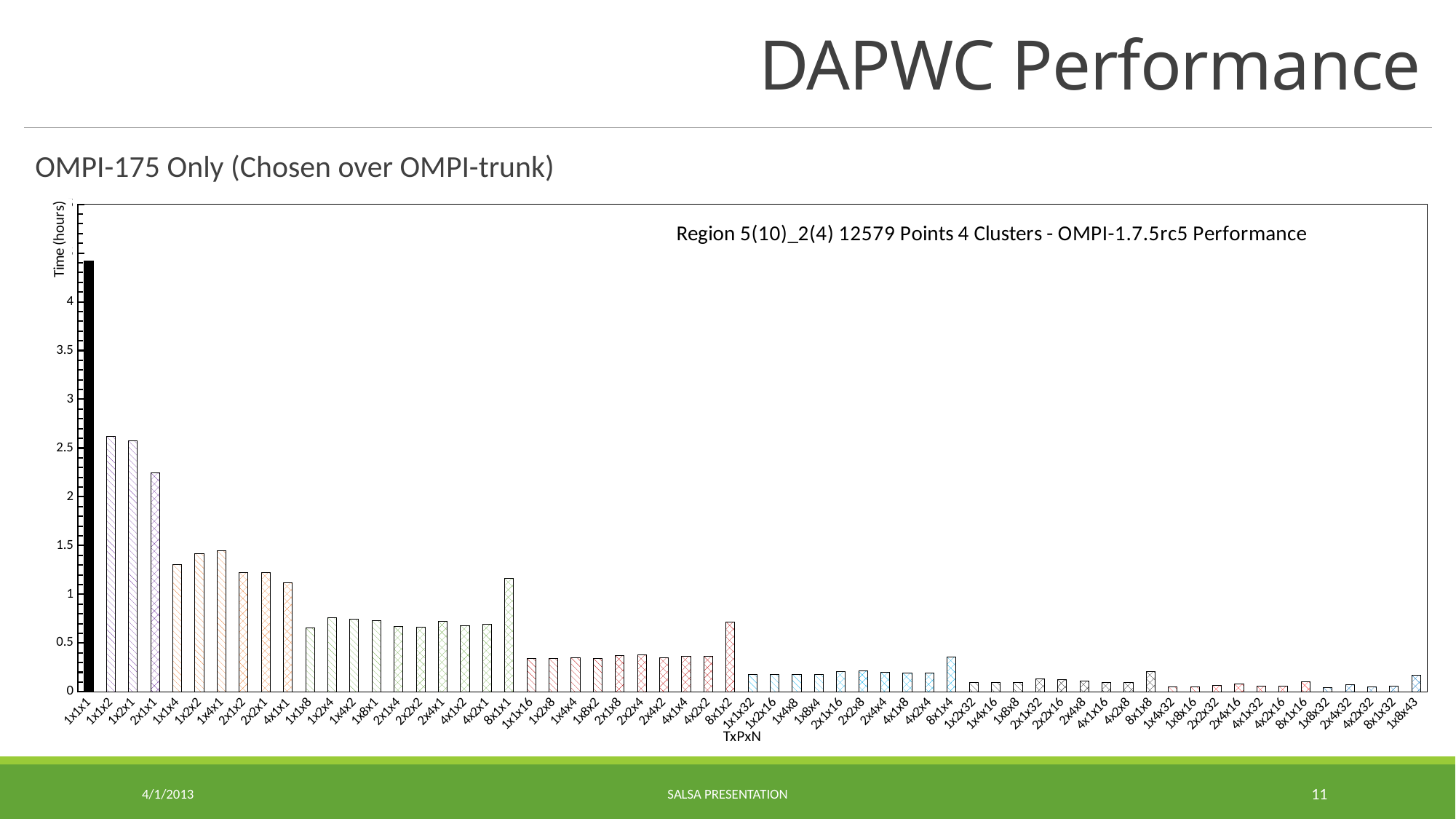
Is the value for 1x1x2 greater or less than 2.5? greater Which has a larger time, 1x1x2 or 2x1x1? 1x1x2 Which TxPxN configuration has the highest time? 1x1x1 What is the label of the y axis? Time (hours) Which has a larger time, 8x1x1 or 1x1x8? 8x1x1 Is the value for 1x1x16 greater or less than 0.5? less Is the value for 1x1x1 greater or less than 4? greater What kind of chart is shown on the slide? bar chart What is the title printed inside the chart? Region 5(10)_2(4) 12579 Points 4 Clusters - OMPI-1.7.5rc5 Performance Overall, do the times rise or fall moving from left to right along the x axis? fall